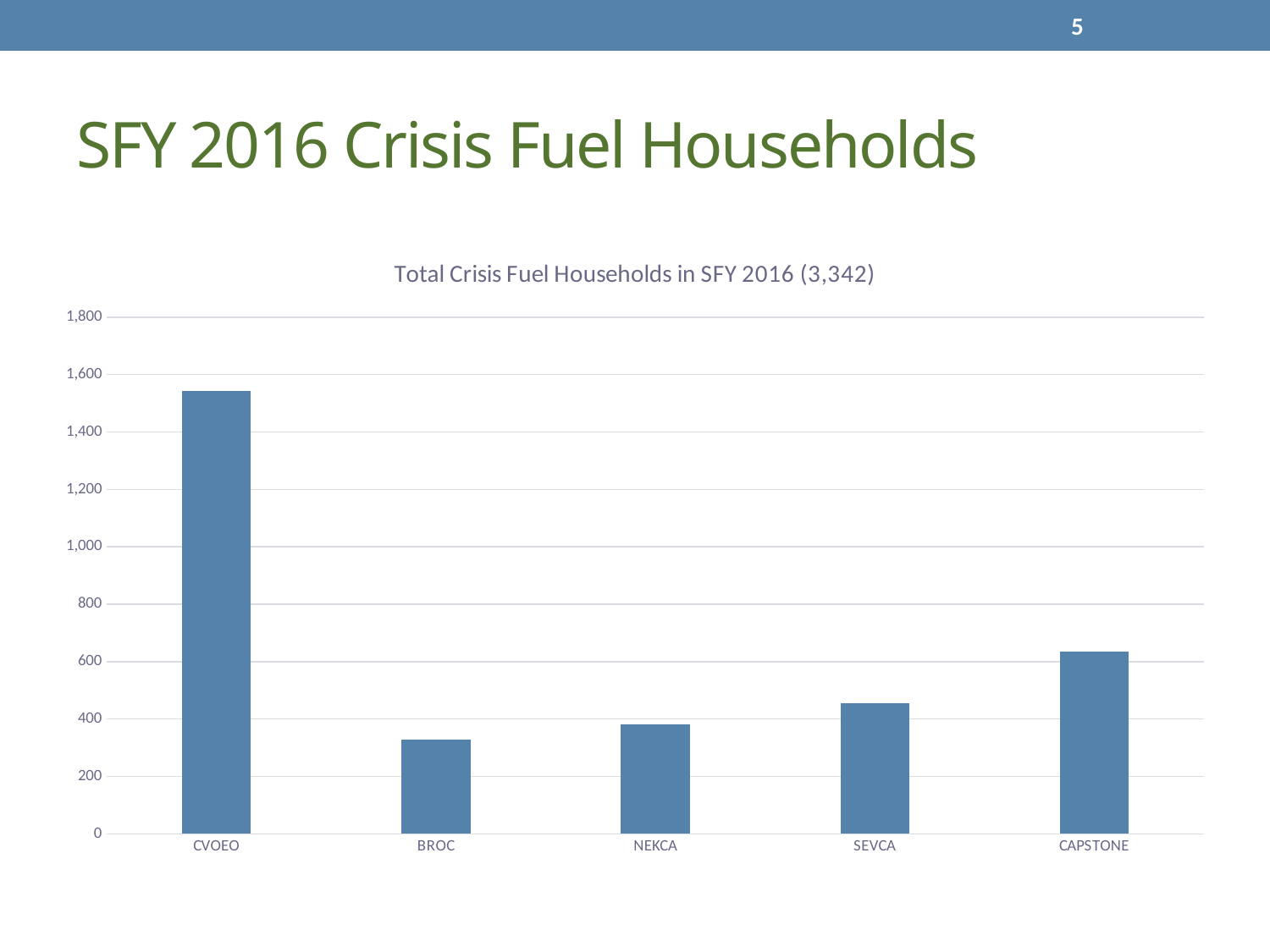
Is the value for CVOEO greater or less than 1,400? greater Is the value for BROC greater or less than 400? less What is the title of the chart? Total Crisis Fuel Households in SFY 2016 (3,342) What kind of chart is shown on the slide? bar chart Which category has the lowest value in the chart? BROC Which category has the highest value in the chart? CVOEO Which is larger, the value for CAPSTONE or the value for SEVCA? CAPSTONE What total number of households is given in the chart title? 3,342 Is the value for SEVCA greater or less than 600? less How many categories are shown on the x axis of the chart? 5 Which is larger, the value for NEKCA or the value for BROC? NEKCA